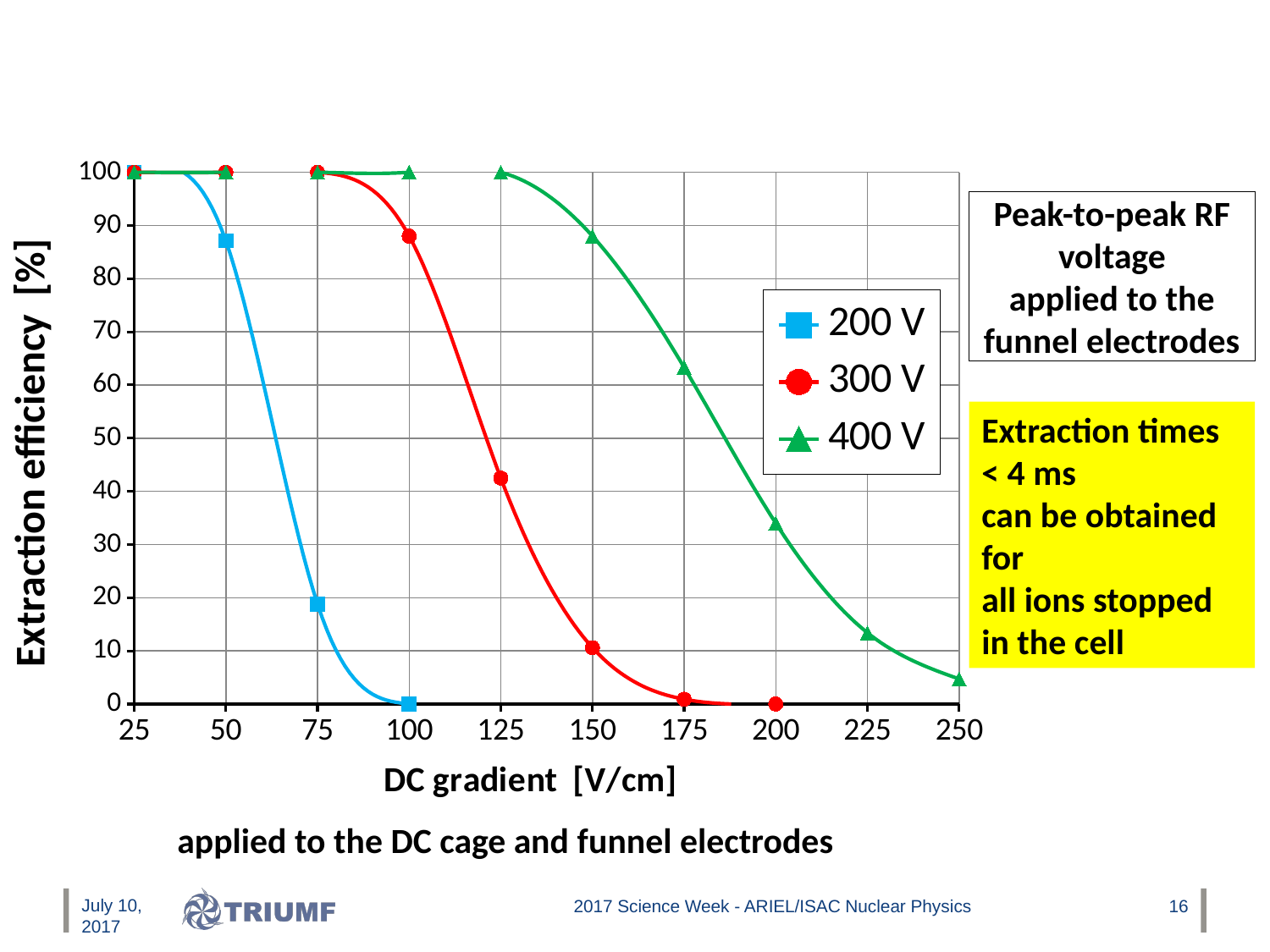
Is the value for the 400 V series at 200 V/cm greater or less than 40? less Is the value for the 400 V series at 250 V/cm greater or less than 10? less What is the extraction efficiency for the 400 V series at a DC gradient of 125 V/cm? 100 At a DC gradient of 150 V/cm, which series has the higher extraction efficiency, 300 V or 400 V? 400 V What is the extraction efficiency for the 300 V series at a DC gradient of 200 V/cm? 0 What is the extraction efficiency for the 200 V series at a DC gradient of 100 V/cm? 0 Do the extraction efficiency values rise or fall as the DC gradient increases? fall What kind of chart is shown on the slide? line chart How many series does the legend list? 3 Is the value for the 200 V series at 50 V/cm greater or less than 80? greater What is the label of the x axis? DC gradient [V/cm]